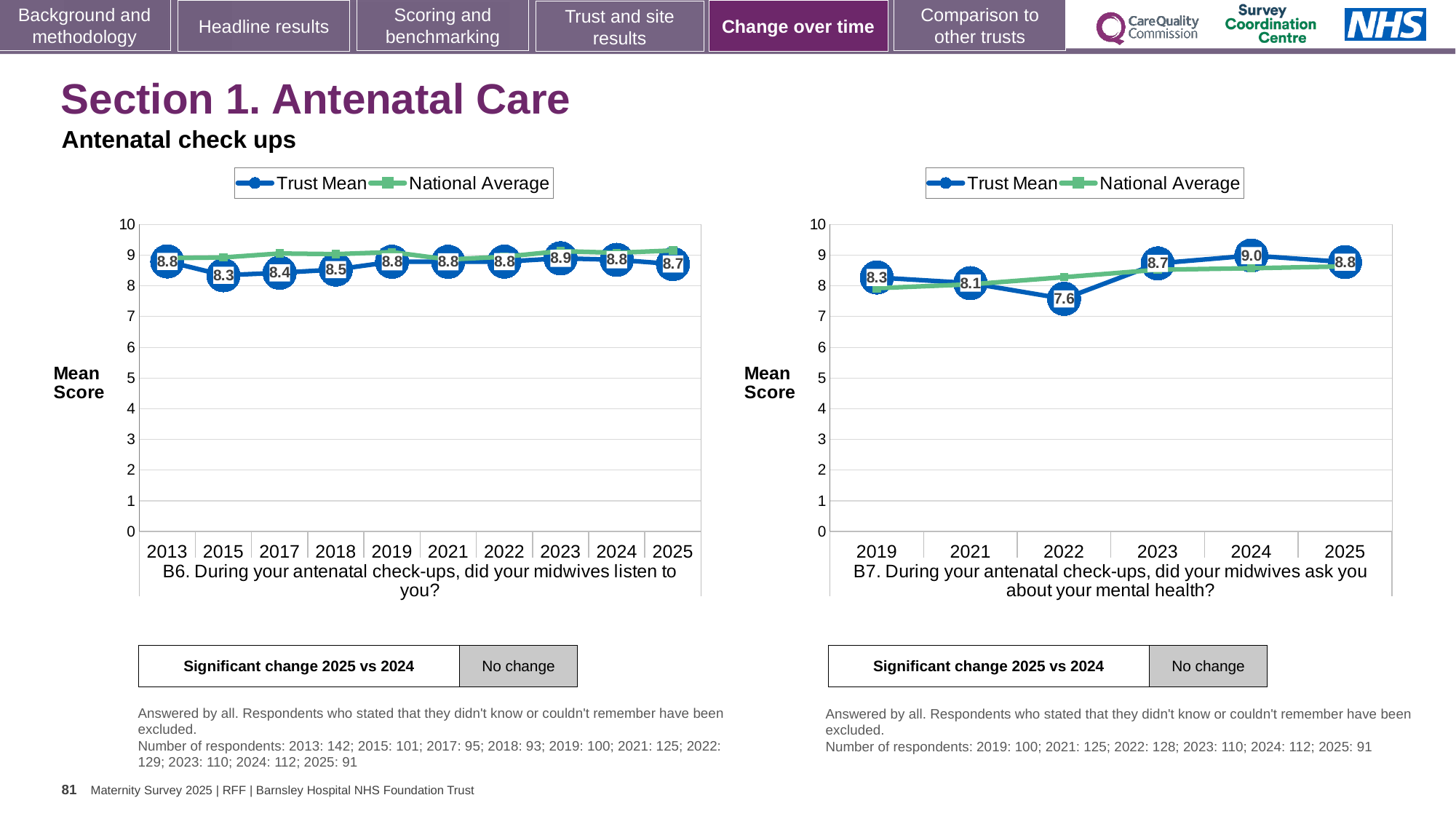
In the B6 chart (left), what is the Trust Mean for 2025? 8.7 In the B7 chart (right), which year has the highest Trust Mean? 2024 In the B7 chart (right), what is the difference between the Trust Mean for 2024 and 2022? 1.4 What kind of chart is the B6 chart (left)? Line chart In the B6 chart (left), which year has the lowest Trust Mean? 2015 In the B7 chart (right), is the National Average for 2019 greater or less than 9? less How many series does the legend of the B7 chart (right) list? 2 In the B6 chart (left), how many years are plotted on the x axis? 10 In the B7 chart (right), what is the Trust Mean for 2022? 7.6 In the B6 chart (left), which year has the highest Trust Mean? 2023 In the B6 chart (left), what is the Trust Mean for 2013? 8.8 In the B7 chart (right), is the Trust Mean for 2019 or 2023 larger? 2023